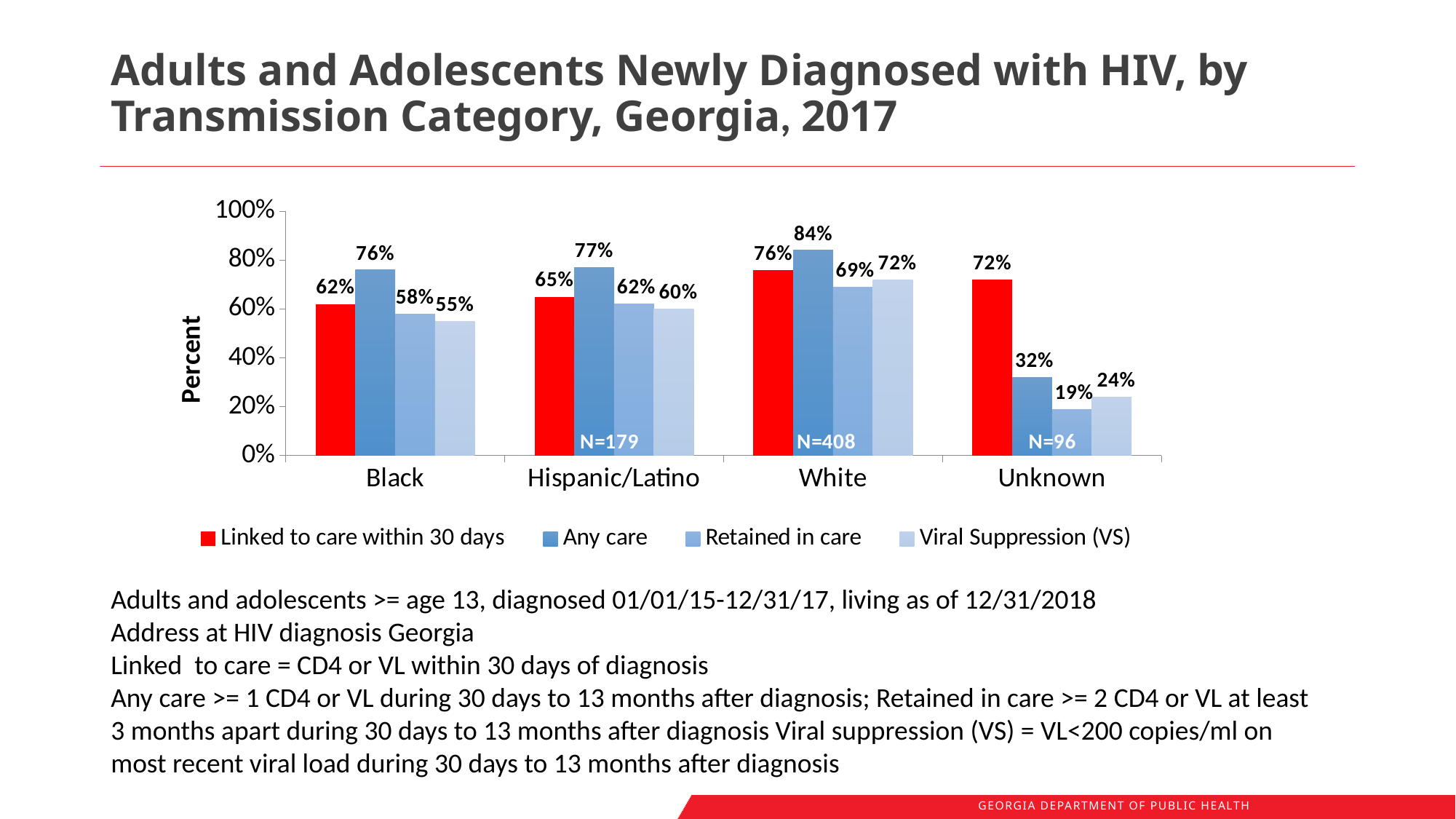
What is the value for Viral Suppression (VS) in the Black category? 55% Which category has the highest value for Any care? White How many categories are shown on the x axis? 4 What is the label of the y axis? Percent What is the value for Retained in care in the Unknown category? 19% What is the difference between Any care and Retained in care in the Hispanic/Latino category? 15% What is the value for Any care in the White category? 84% What kind of chart is shown on the slide? Bar chart How many series does the legend list? 4 Which is larger: Linked to care within 30 days for Unknown or Linked to care within 30 days for Black? Unknown What is the value for Linked to care within 30 days in the Hispanic/Latino category? 65% Which category has the lowest value for Viral Suppression (VS)? Unknown